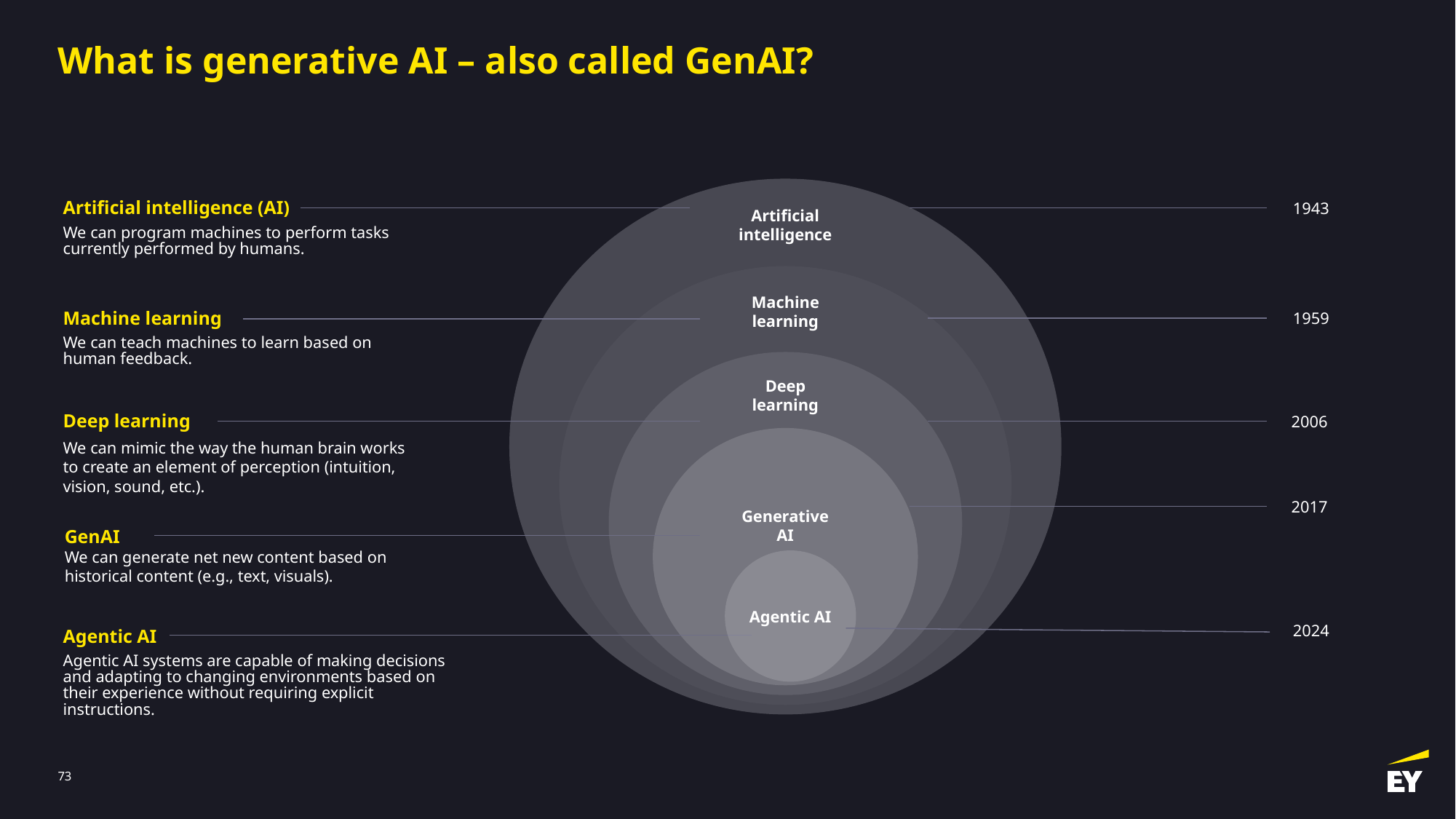
What year is shown next to Artificial intelligence in the nested circle diagram? 1943 What year is shown next to Generative AI in the nested circle diagram? 2017 How many years separate Deep learning (2006) and Generative AI (2017) in the diagram? 11 Which concept in the nested circle diagram has the latest year? Agentic AI What year is shown next to Machine learning in the nested circle diagram? 1959 Which concept is in the outermost (largest) circle of the diagram? Artificial intelligence How many years separate Artificial intelligence (1943) and Agentic AI (2024) in the diagram? 81 What year is shown next to Agentic AI in the nested circle diagram? 2024 What year is shown next to Deep learning in the nested circle diagram? 2006 Which concept in the nested circle diagram has the earliest year? Artificial intelligence How many nested circles are shown in the diagram? 5 Which concept is in the innermost (smallest) circle of the diagram? Agentic AI